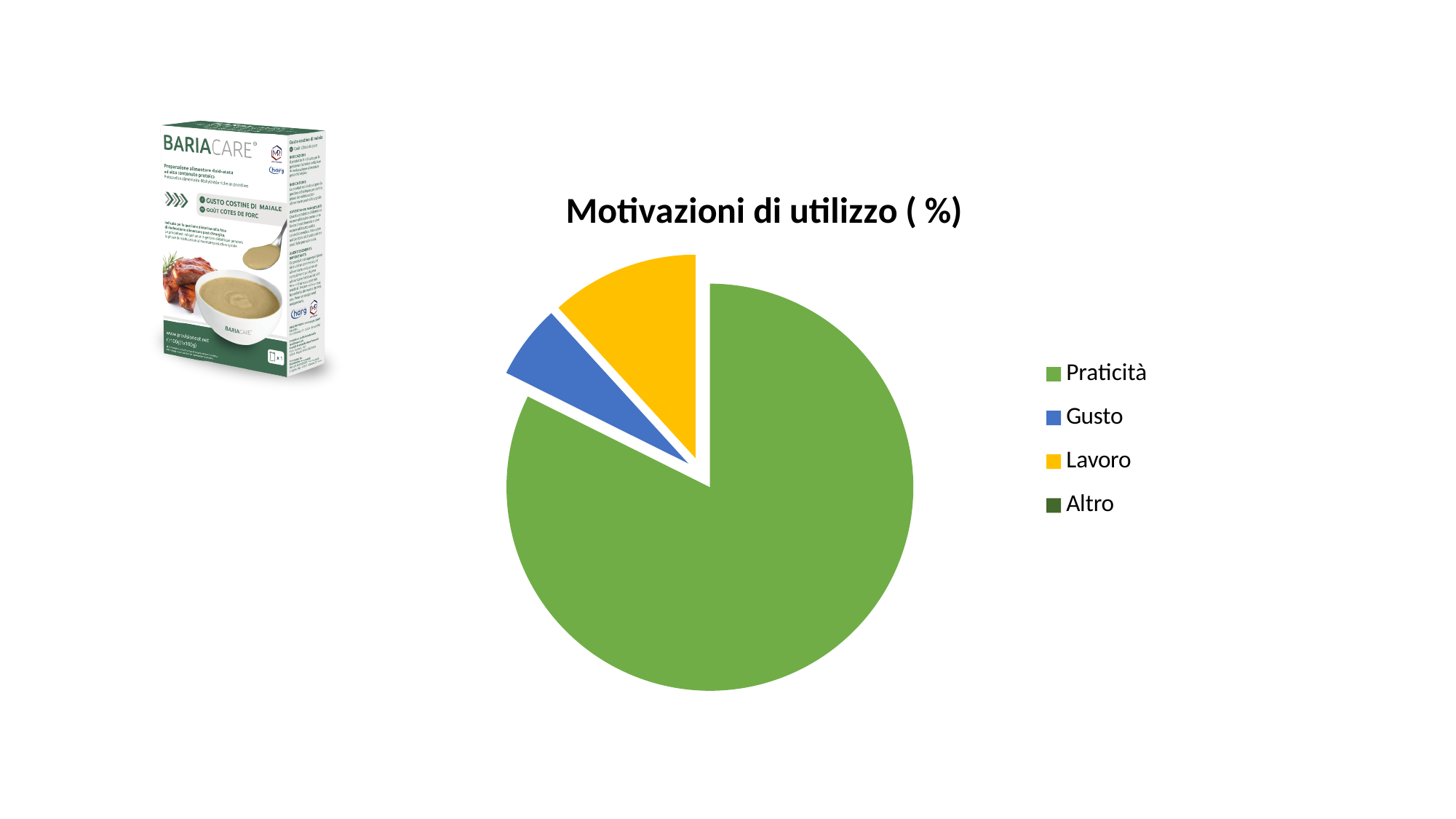
What is the title of the chart? Motivazioni di utilizzo ( %) How many categories does the legend list? 4 Which slice is larger, Lavoro or Gusto? Lavoro Which category has the largest slice of the pie? Praticità Which slice is larger, Praticità or Gusto? Praticità What kind of chart is shown on the slide? pie chart Which slice is larger, Praticità or Lavoro? Praticità What colour is the Lavoro slice? yellow